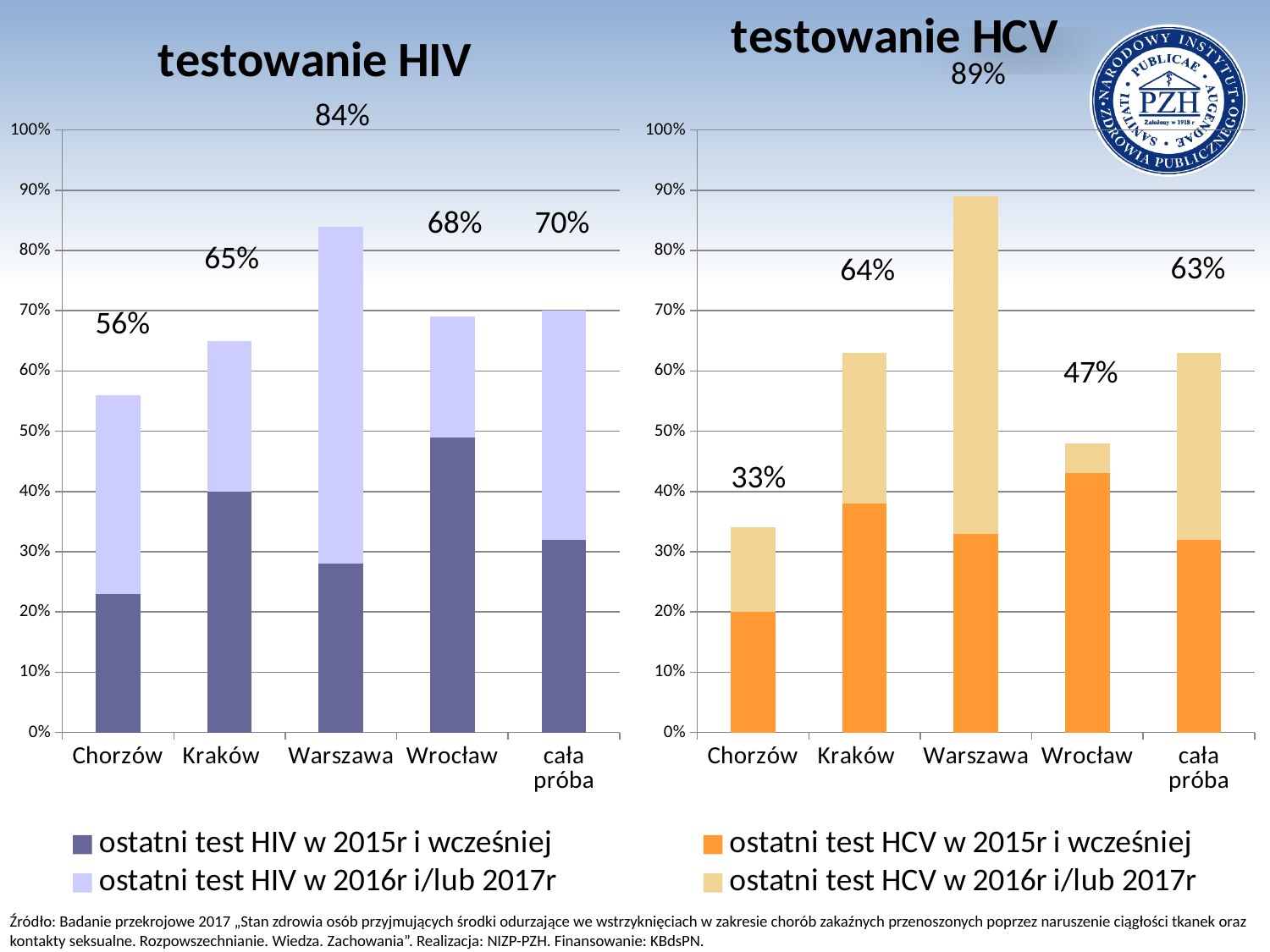
In the 'testowanie HCV' chart, what is the total labelled for Wrocław? 47% In the 'testowanie HIV' chart, what is the total labelled for Warszawa? 84% How many categories are shown on the x axis of the 'testowanie HCV' chart? 5 How many series does the legend of the 'testowanie HIV' chart list? 2 In the 'testowanie HCV' chart, is the value of the 'ostatni test HCV w 2015r i wcześniej' segment for Warszawa greater or less than 40%? less In the 'testowanie HIV' chart, which city has the lowest labelled total? Chorzów In the 'testowanie HCV' chart, what is the difference between the labelled totals for Warszawa and Chorzów? 56% In the 'testowanie HIV' chart, is the value of the 'ostatni test HIV w 2015r i wcześniej' segment for Chorzów greater or less than 30%? less What kind of chart is 'testowanie HCV'? stacked bar chart In the 'testowanie HIV' chart, which is larger: the labelled total for Kraków or for Wrocław? Wrocław In the 'testowanie HCV' chart, which category has the highest labelled total? Warszawa In the 'testowanie HIV' chart, what is the labelled total for 'cała próba'? 70%